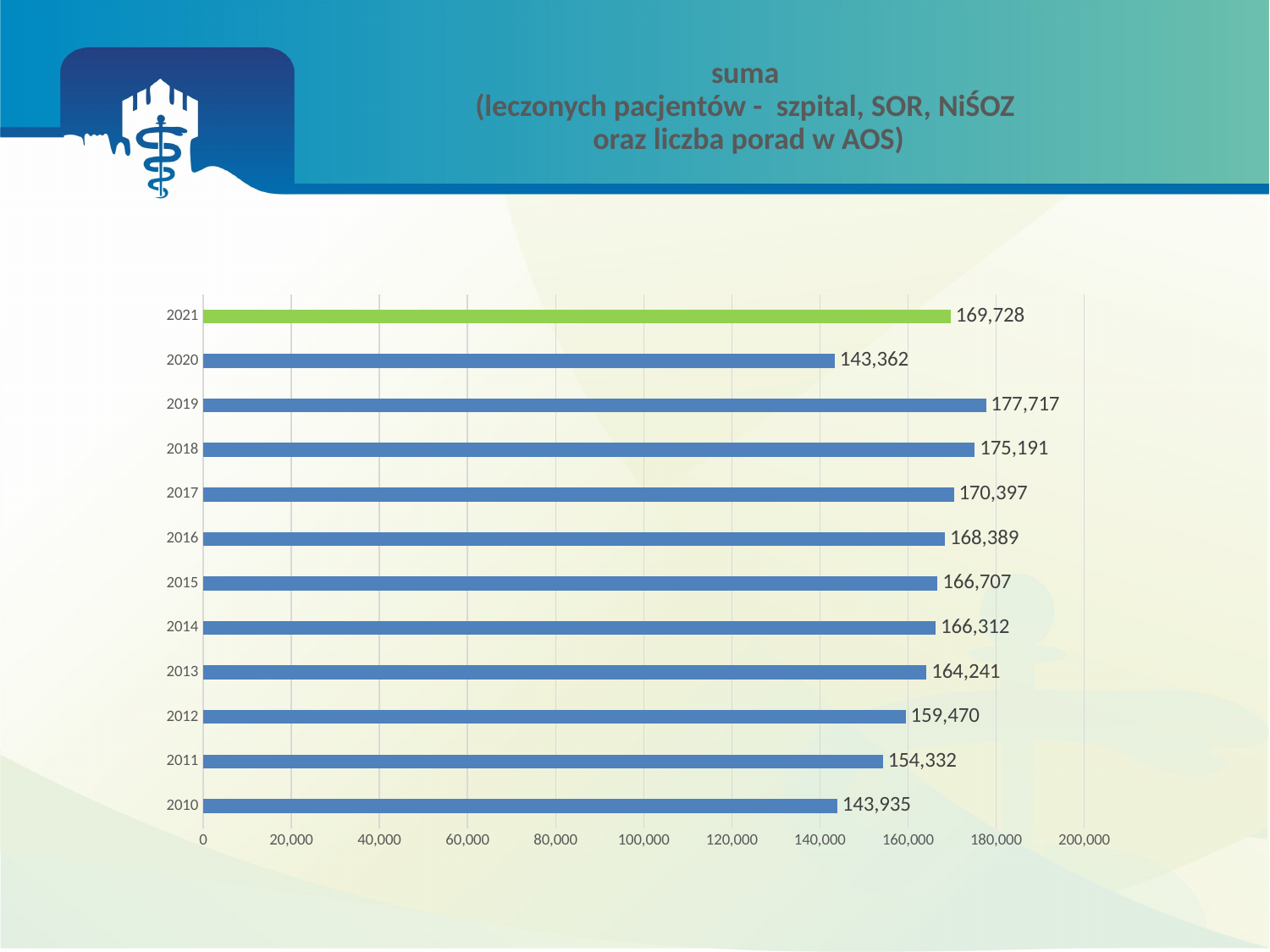
What kind of chart is shown on the slide? bar chart How many years are shown in the chart? 12 Is the value for 2011 greater or less than 160,000? less Which year has the highest value? 2019 What is the difference between the values for 2019 and 2018? 2,526 What is the value shown for 2015? 166,707 What is the value shown for 2021? 169,728 What is the value shown for 2010? 143,935 What is the difference between the values for 2021 and 2020? 26,366 Do the values rise or fall from 2010 to 2019? rise Which is larger, the value for 2017 or the value for 2016? 2017 Which year has the lowest value? 2020